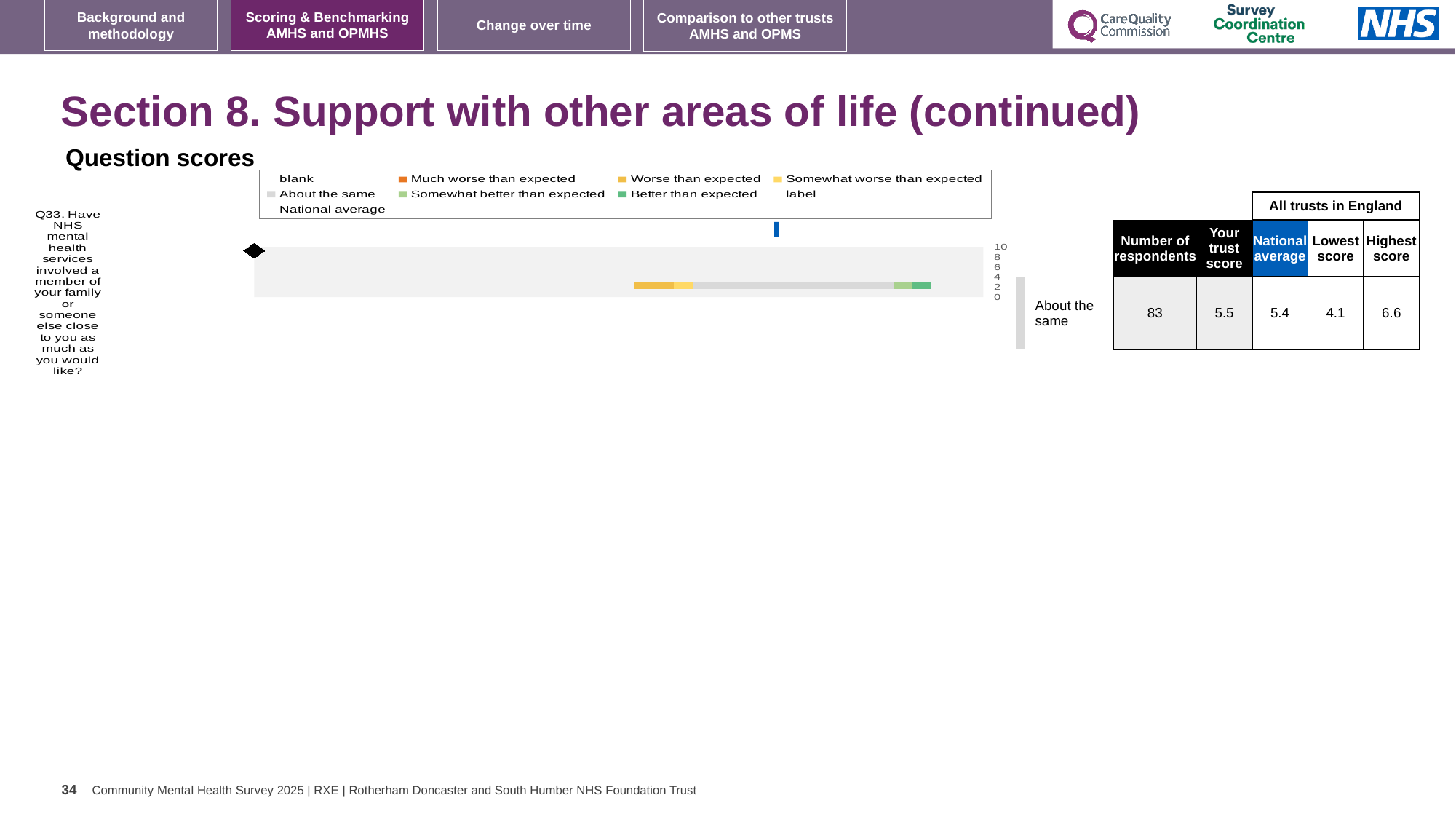
What is the highest tick value shown on the axis of the Question scores chart? 10 What category label is shown next to the bar for Q33 in the Question scores chart? About the same Which question is plotted in the Question scores chart? Q33. Have NHS mental health services involved a member of your family or someone else close to you as much as you would like? What kind of chart is shown under 'Question scores'? bar chart How many legend entries in the Question scores chart contain the words 'than expected'? 5 How many questions (categories) are plotted in the Question scores chart? 1